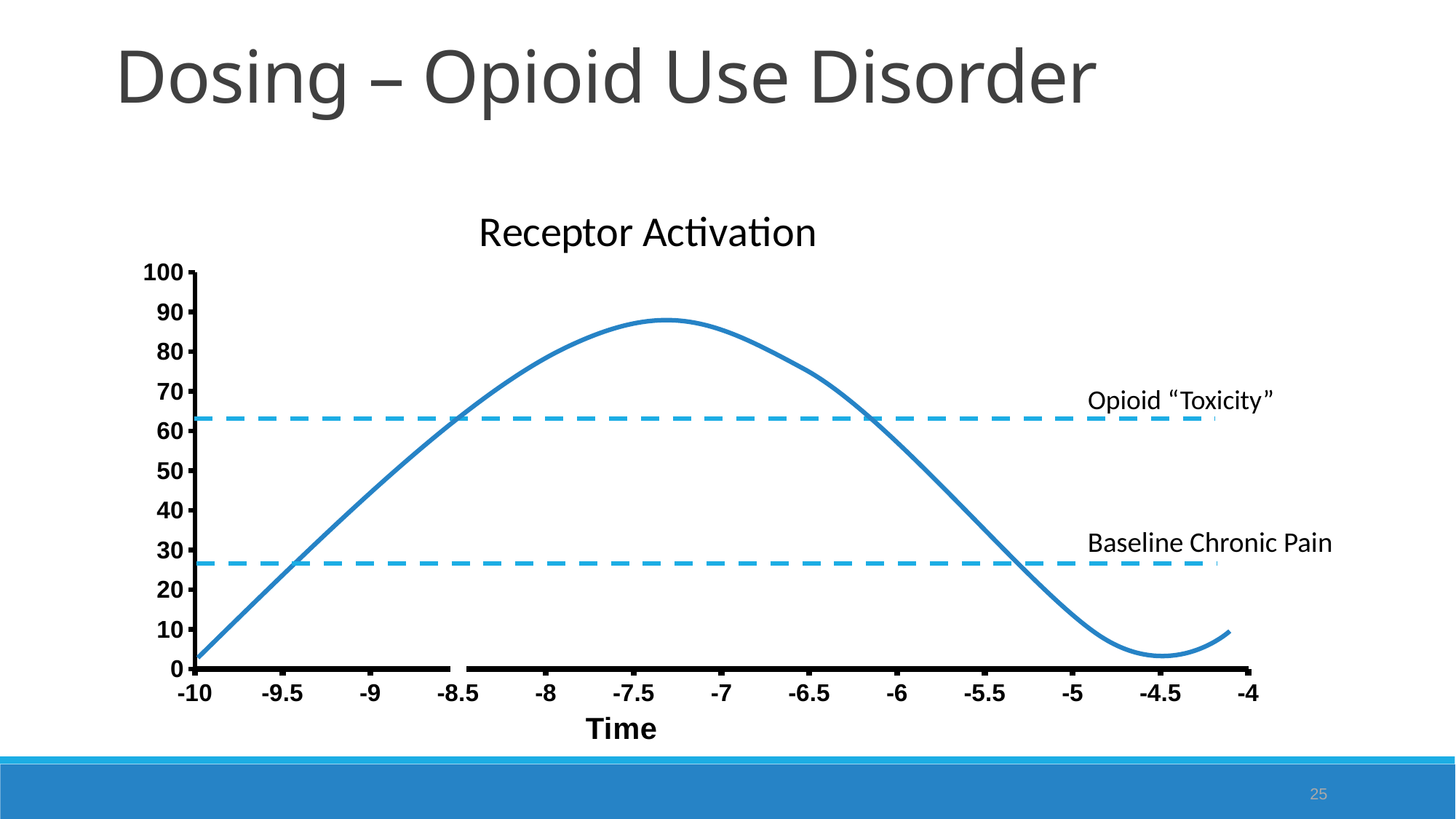
Does the Receptor Activation curve rise or fall between time -10 and time -7.5? rise What kind of chart is shown on the slide? line chart Is the dashed 'Baseline Chronic Pain' line above or below 40 on the y axis? below Is the value of the Receptor Activation curve at time -5 greater or less than 20? less Does the Receptor Activation curve rise or fall between time -7.5 and time -4.5? fall Is the value of the Receptor Activation curve at time -9 greater or less than 30? greater What is the title of the chart? Receptor Activation What is the label of the x axis? Time